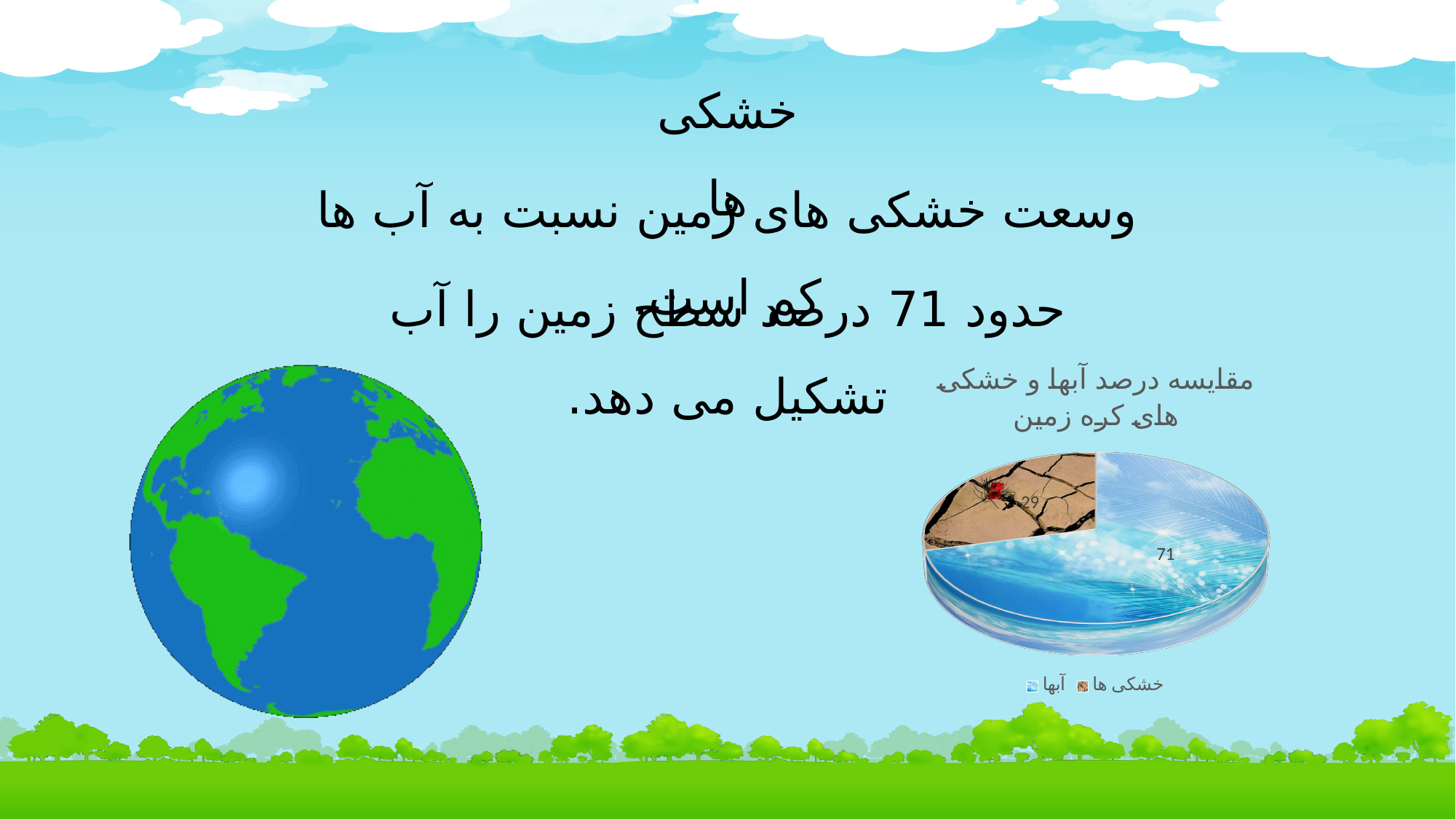
Which slice of the pie chart is the largest? آبها How many slices does the pie chart have? 2 What is the title of the pie chart? مقایسه درصد آبها و خشکی های کره زمین Which is larger in the pie chart, آبها or خشکی ها? آبها What is the value shown for خشکی ها in the pie chart? 29 Which slice of the pie chart is the smallest? خشکی ها How many entries does the legend of the pie chart list? 2 What kind of chart is shown on the slide? pie chart What share of the pie chart does the آبها slice represent? 71% What are the two legend entries of the pie chart? آبها and خشکی ها What is the value shown for آبها in the pie chart? 71 What is the difference between the values for آبها and خشکی ها in the pie chart? 42